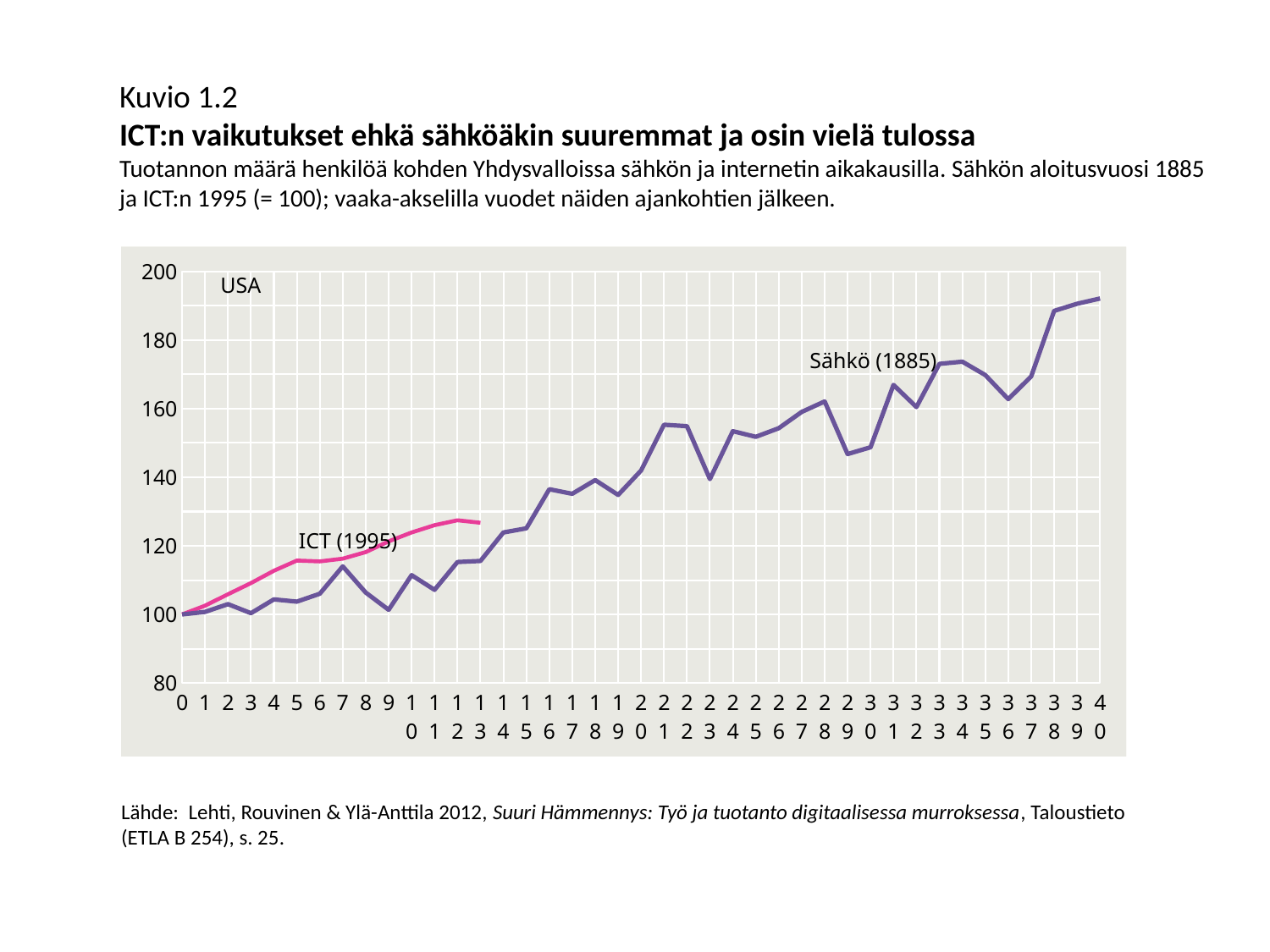
Which series reaches the highest value in the chart? Sähkö (1885) Is the value of the Sähkö (1885) series at year 40 greater or less than 180? greater At year 13, which series has the higher value, ICT (1995) or Sähkö (1885)? ICT (1995) What is the value of both series at year 0 on the horizontal axis? 100 Is the value of the ICT (1995) series at year 13 greater or less than 120? greater What kind of chart is shown on the slide? line chart Is the value of the Sähkö (1885) series at year 9 greater or less than 120? less What are the names of the two series plotted in the chart? Sähkö (1885) and ICT (1995) What is the last year shown on the horizontal axis? 40 Does the Sähkö (1885) series generally rise or fall along the horizontal axis? rise What is the highest value shown on the vertical axis? 200 How many series are plotted in the chart? 2